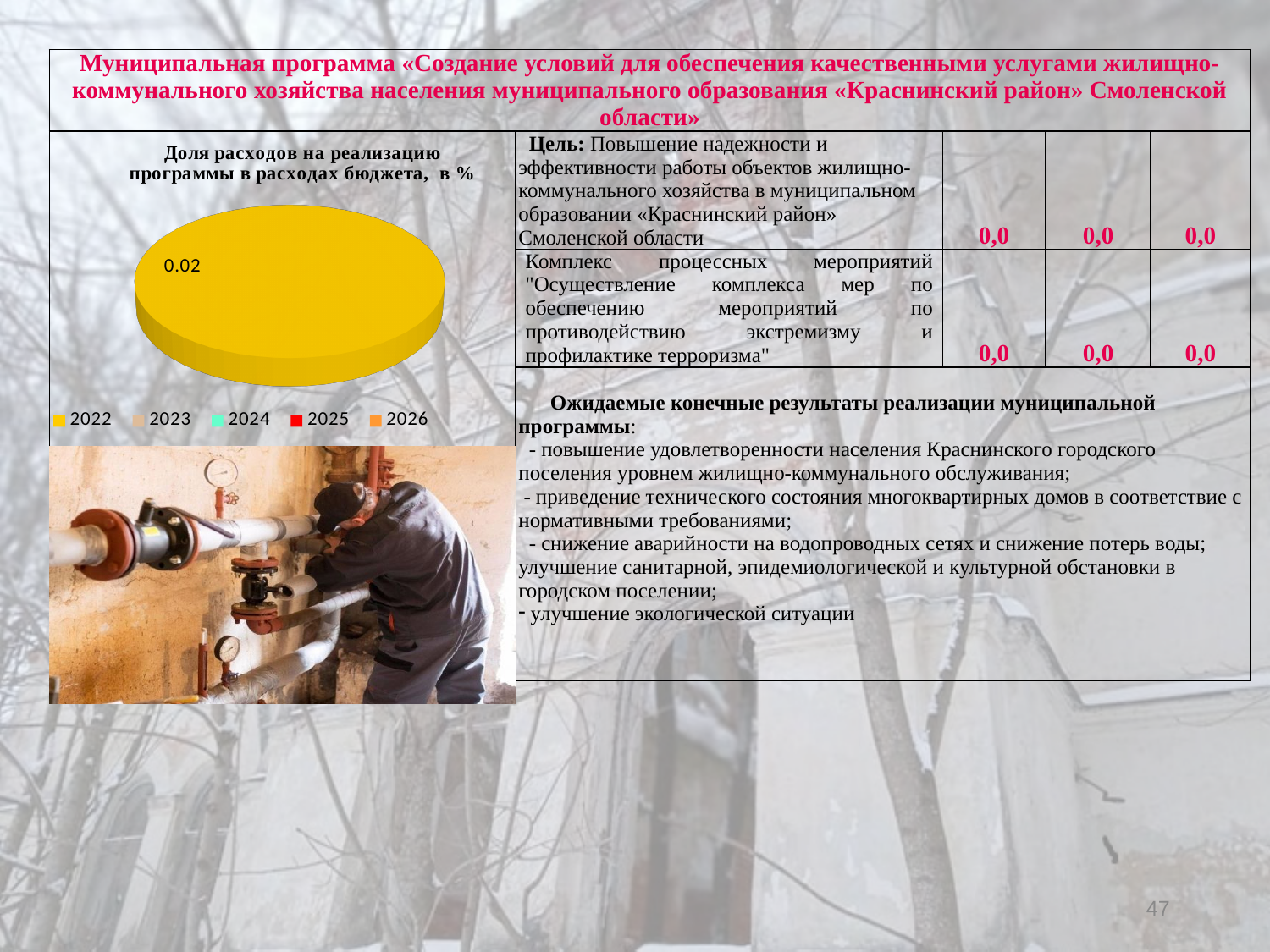
What is the value shown for 2022 in the pie chart? 0.02 What share of the pie does the 2022 slice occupy? 100% Which year has the largest slice in the pie chart? 2022 How many data labels are printed on the pie chart? 1 What is the title of the chart on the slide? Доля расходов на реализацию программы в расходах бюджета, в % What value is labelled on the pie chart? 0.02 What kind of chart is shown on the slide? pie chart How many entries does the chart legend list? 5 Which years are listed in the chart legend? 2022, 2023, 2024, 2025, 2026